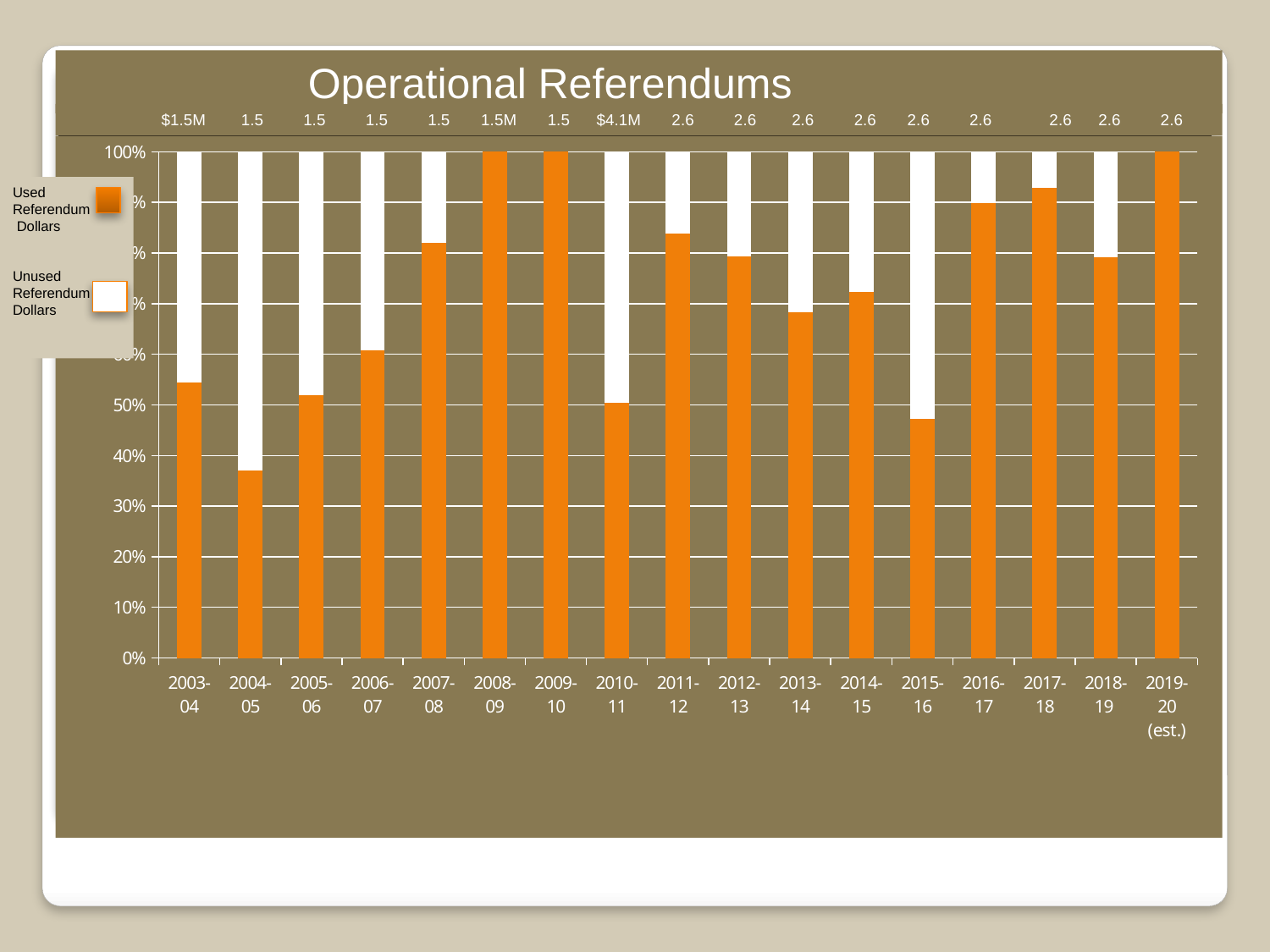
Is the share of Used Referendum Dollars for 2004-05 greater or less than 40%? less Which colour represents Used Referendum Dollars in the chart? orange Which year has the lowest share of Used Referendum Dollars? 2004-05 What is the share of Unused Referendum Dollars for 2009-10? 0% How many series does the legend list? 2 What type of chart is shown on the slide? bar chart What is the share of Used Referendum Dollars for 2008-09? 100% Is the share of Used Referendum Dollars for 2015-16 greater or less than 50%? less What is the title of the chart? Operational Referendums Is the share of Used Referendum Dollars for 2017-18 greater or less than 90%? greater How many school years are shown along the x axis? 17 Which year has a larger share of Used Referendum Dollars, 2015-16 or 2016-17? 2016-17